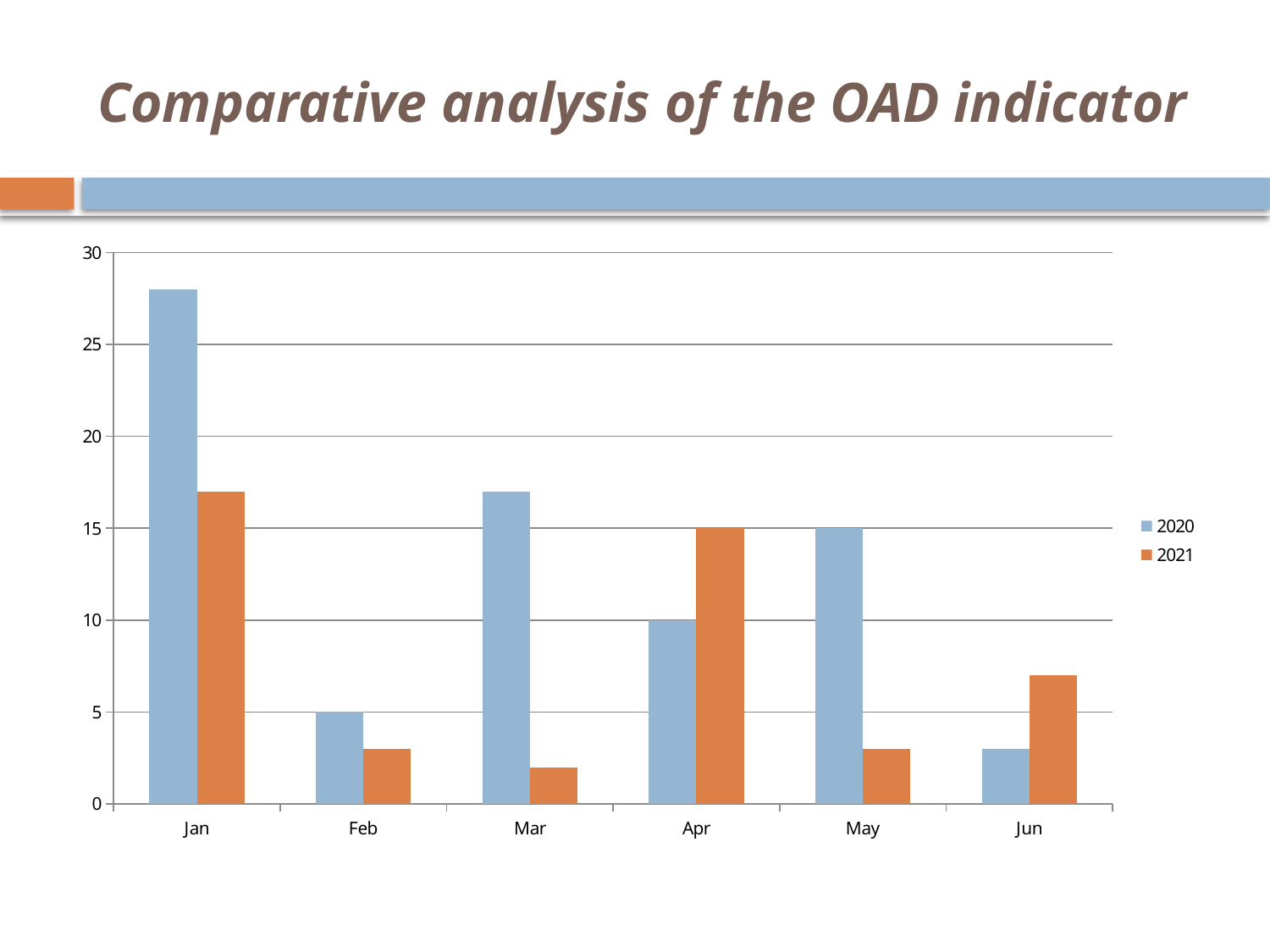
How many series does the legend list? 2 Is the value for 2021 in Mar greater or less than 5? less What is the value for 2020 in May? 15 What is the value for 2020 in Feb? 5 Is the value for 2020 in Jan greater or less than 25? greater What is the value for 2021 in Apr? 15 What is the value for 2020 in Apr? 10 Which month has the lowest value for 2021? Mar What kind of chart is shown on the slide? bar chart Which month has the highest value for 2020? Jan In Apr, which series has the larger value, 2020 or 2021? 2021 How many months are shown on the x axis? 6